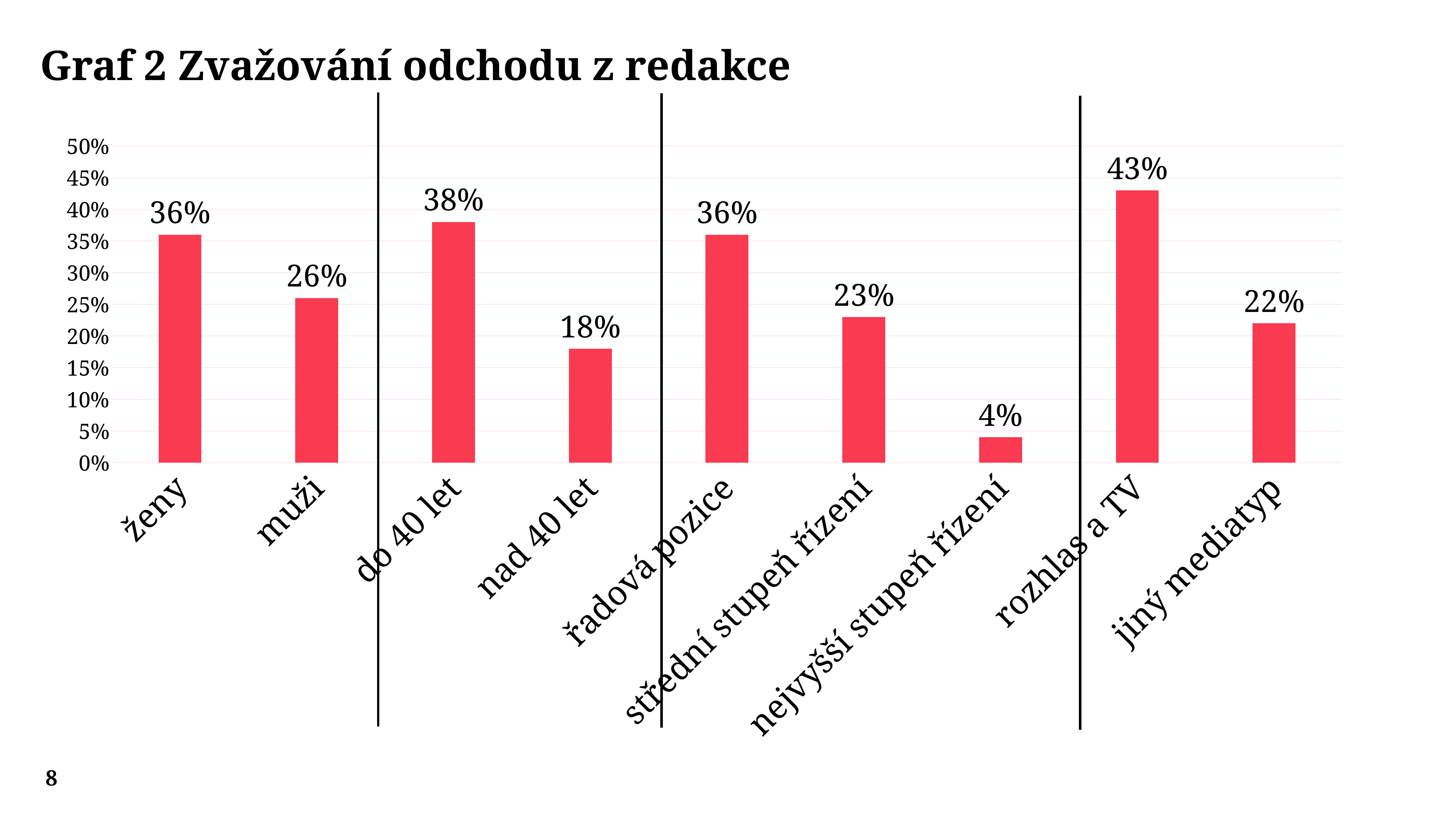
What is the value for nejvyšší stupeň řízení? 4% Which is larger, the value for řadová pozice or the value for střední stupeň řízení? řadová pozice What is the value for nad 40 let? 18% What is the title of the chart? Graf 2 Zvažování odchodu z redakce Which category has the lowest value? nejvyšší stupeň řízení What is the value for muži? 26% What kind of chart is shown on the slide? bar chart Is the value for jiný mediatyp greater or less than 25%? less Which category has the highest value? rozhlas a TV What is the difference between the values for do 40 let and nad 40 let? 20% How many categories are shown on the x axis? 9 What is the value for ženy? 36%